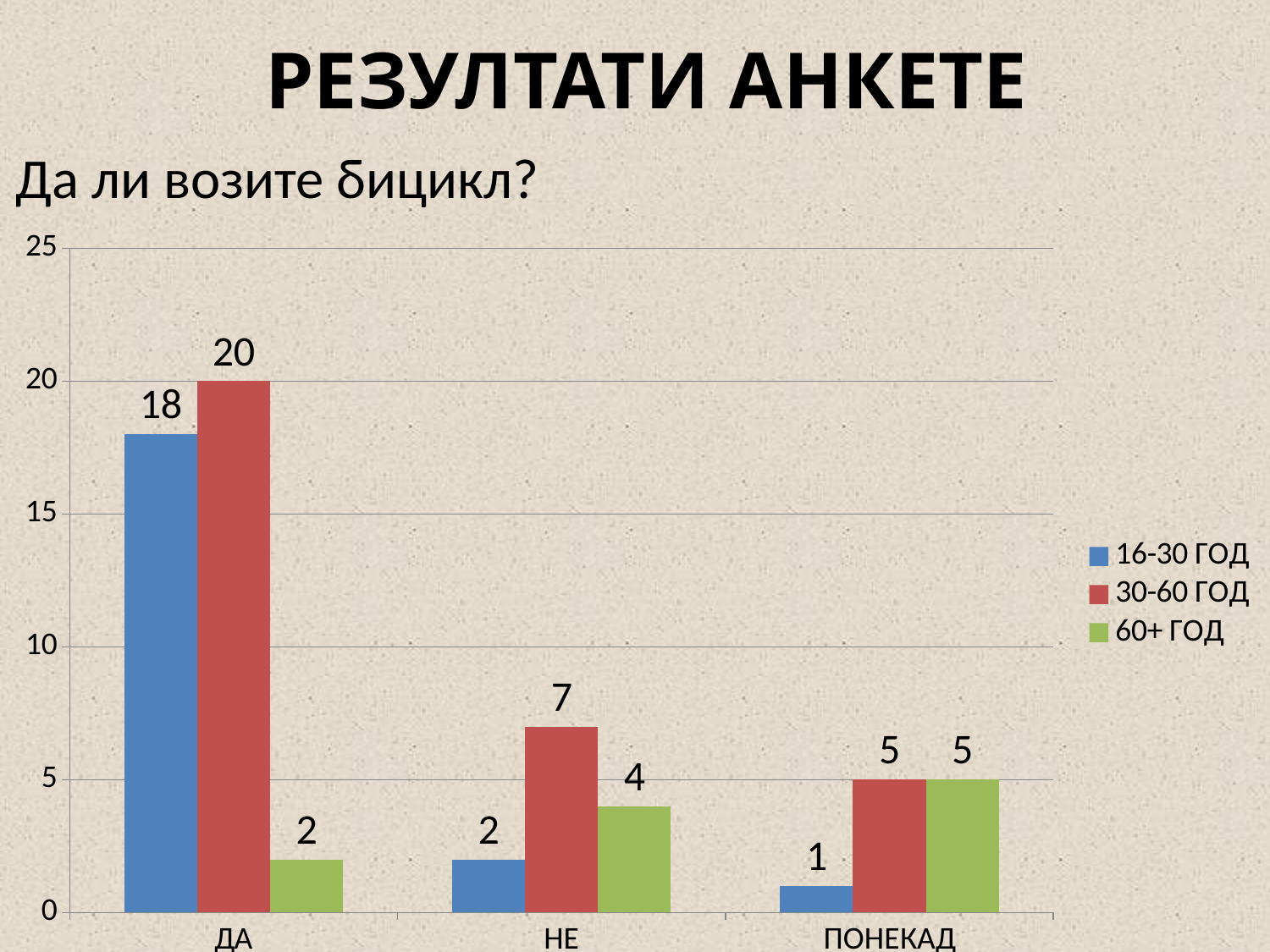
What is the value for the 16-30 ГОД series in the ПОНЕКАД category? 1 What is the value for the 60+ ГОД series in the НЕ category? 4 Which is larger in the НЕ category: the 30-60 ГОД value or the 60+ ГОД value? 30-60 ГОД What is the value for the 30-60 ГОД series in the ДА category? 20 What question is the chart about, as written above it? Да ли возите бицикл? How many series does the legend list? 3 What is the difference between the 30-60 ГОД and 16-30 ГОД values in the ДА category? 2 What kind of chart is shown on the slide? bar chart How many categories are shown on the x axis? 3 Which category has the lowest value for the 30-60 ГОД series? ПОНЕКАД Is the value for 16-30 ГОД in the ДА category greater or less than 15? greater Which category has the highest value for the 16-30 ГОД series? ДА